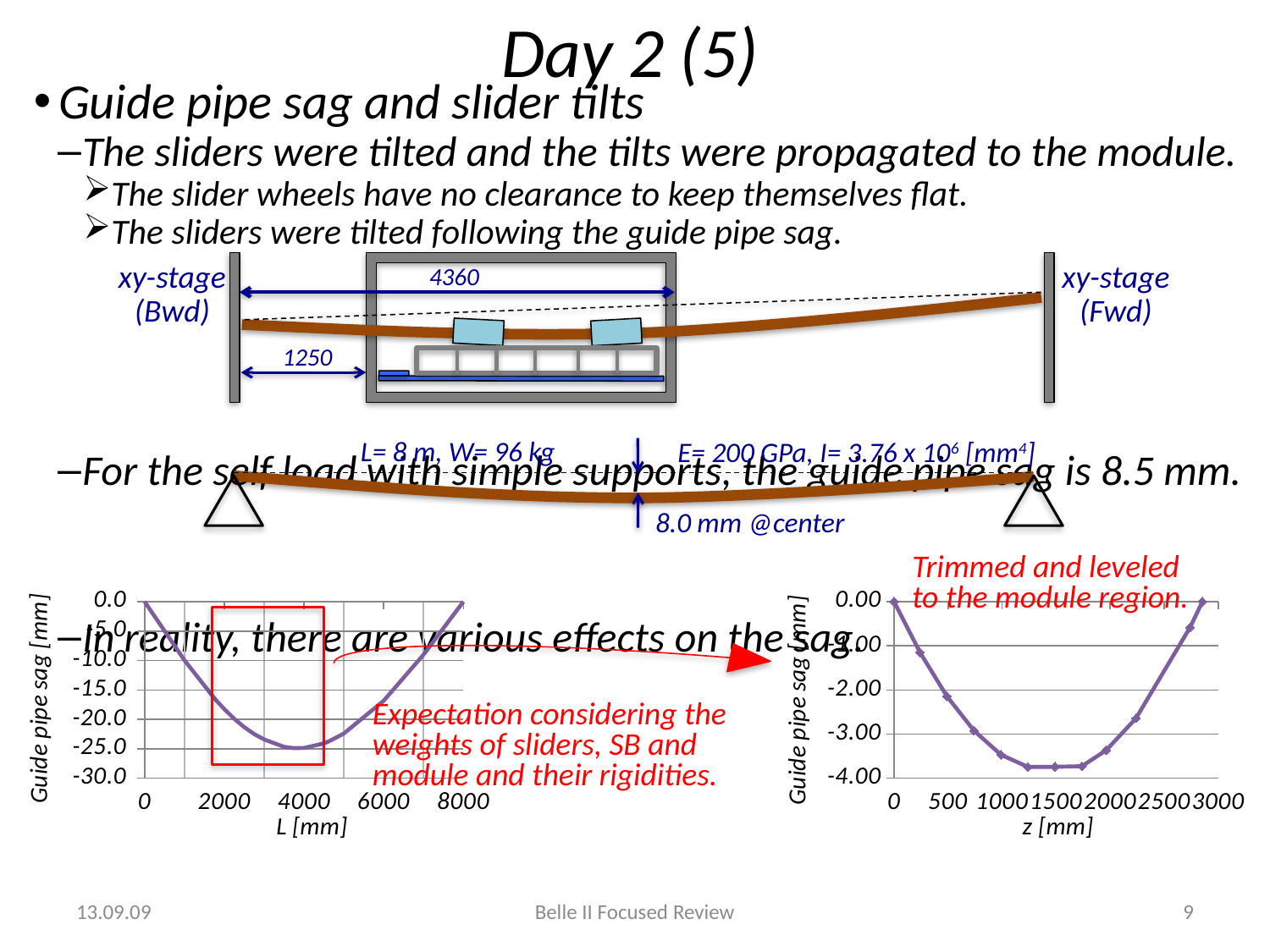
In the left chart (sag vs L [mm]), is the guide pipe sag at L = 4000 greater or less than -20.0? less What kind of chart is the left chart plotting guide pipe sag against L [mm]? line chart In the right chart (sag vs z [mm]), which has the lower (more negative) sag value: z = 500 or z = 1500? z = 1500 What is the x-axis title of the right chart? z [mm] In the left chart (sag vs L [mm]), what is the guide pipe sag at L = 0? 0.0 In the right chart (sag vs z [mm]), is the guide pipe sag at z = 1500 greater or less than -3.00? less In the right chart (sag vs z [mm]), what is the guide pipe sag at z = 0? 0.00 In the left chart (sag vs L [mm]), how does the guide pipe sag change as L increases from 0 to 8000? It falls to a minimum near L = 4000 and then rises back to 0 In the left chart (sag vs L [mm]), which has the lower (more negative) sag value: L = 2000 or L = 4000? L = 4000 In the right chart (sag vs z [mm]), is the guide pipe sag at z = 500 greater or less than -3.00? greater How many data points are plotted in the right chart (sag vs z [mm])? 12